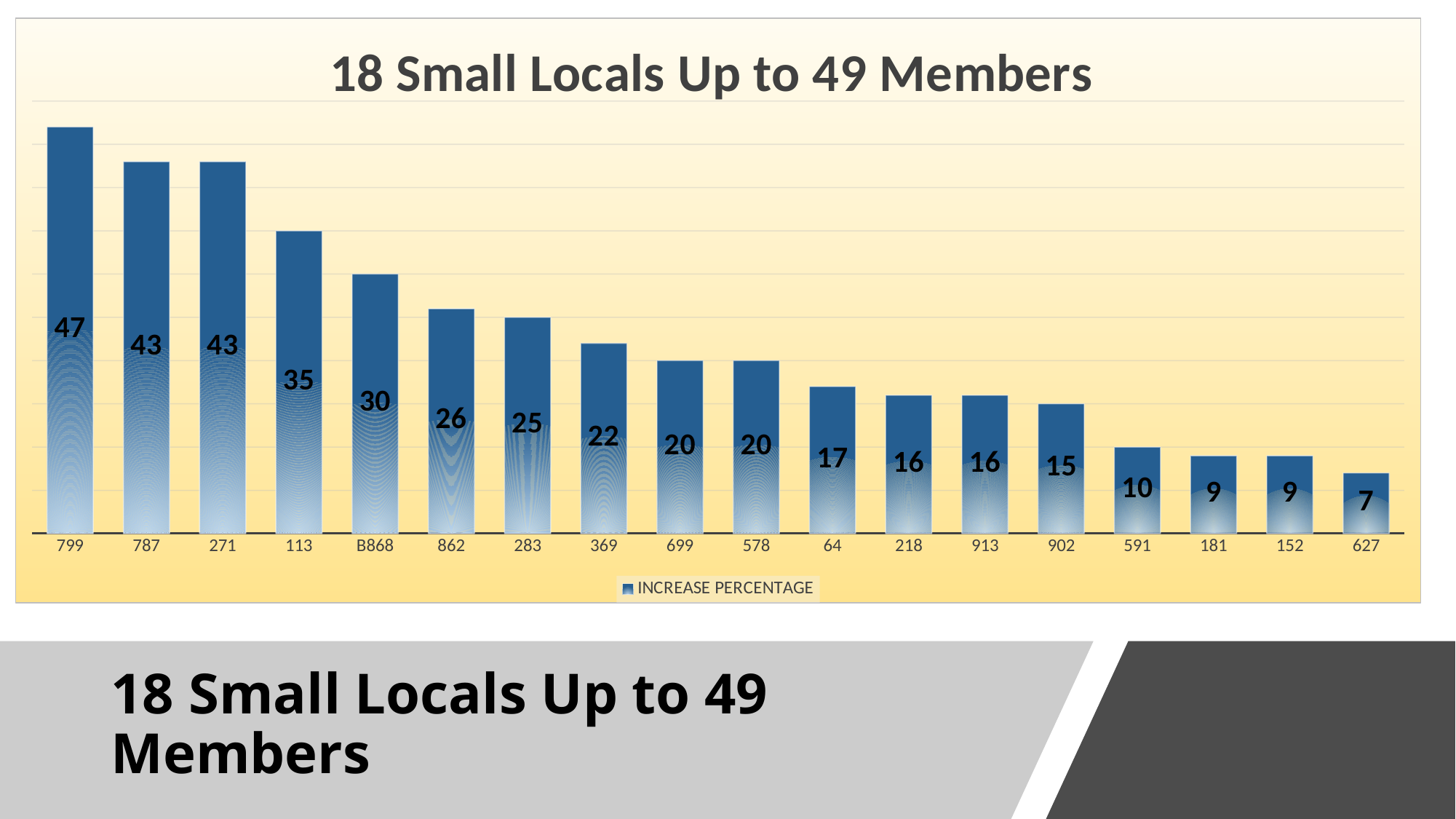
What kind of chart is shown on the slide? Bar chart What is the increase percentage for local 627? 7 What is the increase percentage for local 799? 47 What is the increase percentage for local B868? 30 Which local has the lowest increase percentage? 627 Which has a larger increase percentage, local 862 or local 369? 862 What is the title of the chart? 18 Small Locals Up to 49 Members What is the increase percentage for local 113? 35 What is the difference between the increase percentage for local 799 and local 113? 12 How many series does the legend list? 1 How many locals are shown on the chart? 18 Which local has the highest increase percentage? 799